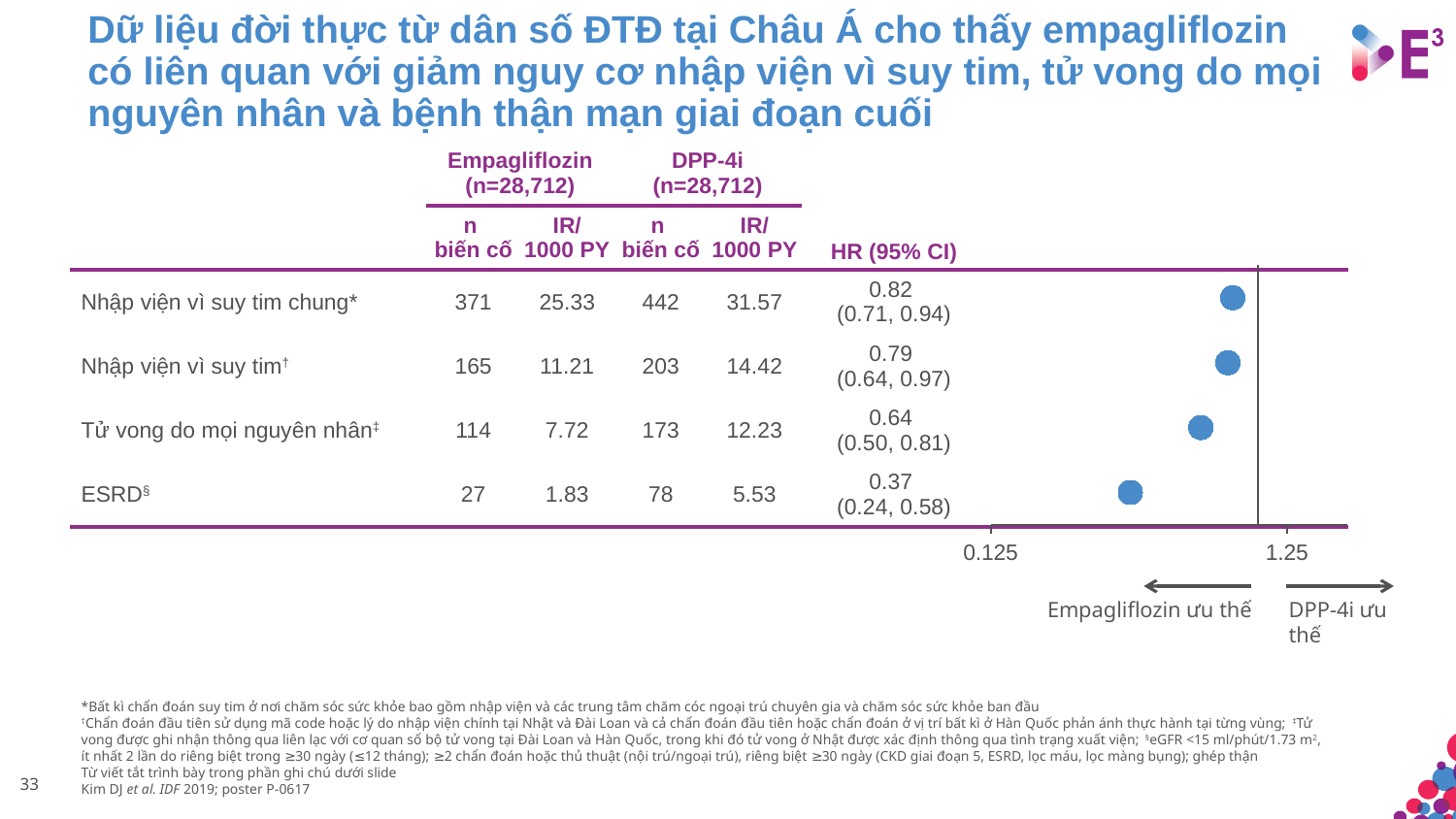
Which has the lower HR: Nhập viện vì suy tim or Tử vong do mọi nguyên nhân? Tử vong do mọi nguyên nhân What is the 95% CI shown for Tử vong do mọi nguyên nhân? (0.50, 0.81) How many outcomes are plotted in the forest plot? 4 What is the difference between the HR for Nhập viện vì suy tim chung and the HR for ESRD? 0.45 What is the HR shown for Nhập viện vì suy tim chung? 0.82 Which outcome has the lowest hazard ratio in the forest plot? ESRD What is the IR/1000 PY for DPP-4i in the ESRD row? 5.53 How many events (n biến cố) are listed for empagliflozin in the Nhập viện vì suy tim row? 165 What label appears under the left-pointing arrow below the plot axis? Empagliflozin ưu thế Is the HR point for ESRD greater or less than 1.25? less What is the hazard ratio (HR) plotted for ESRD? 0.37 Which outcome has the highest hazard ratio in the forest plot? Nhập viện vì suy tim chung